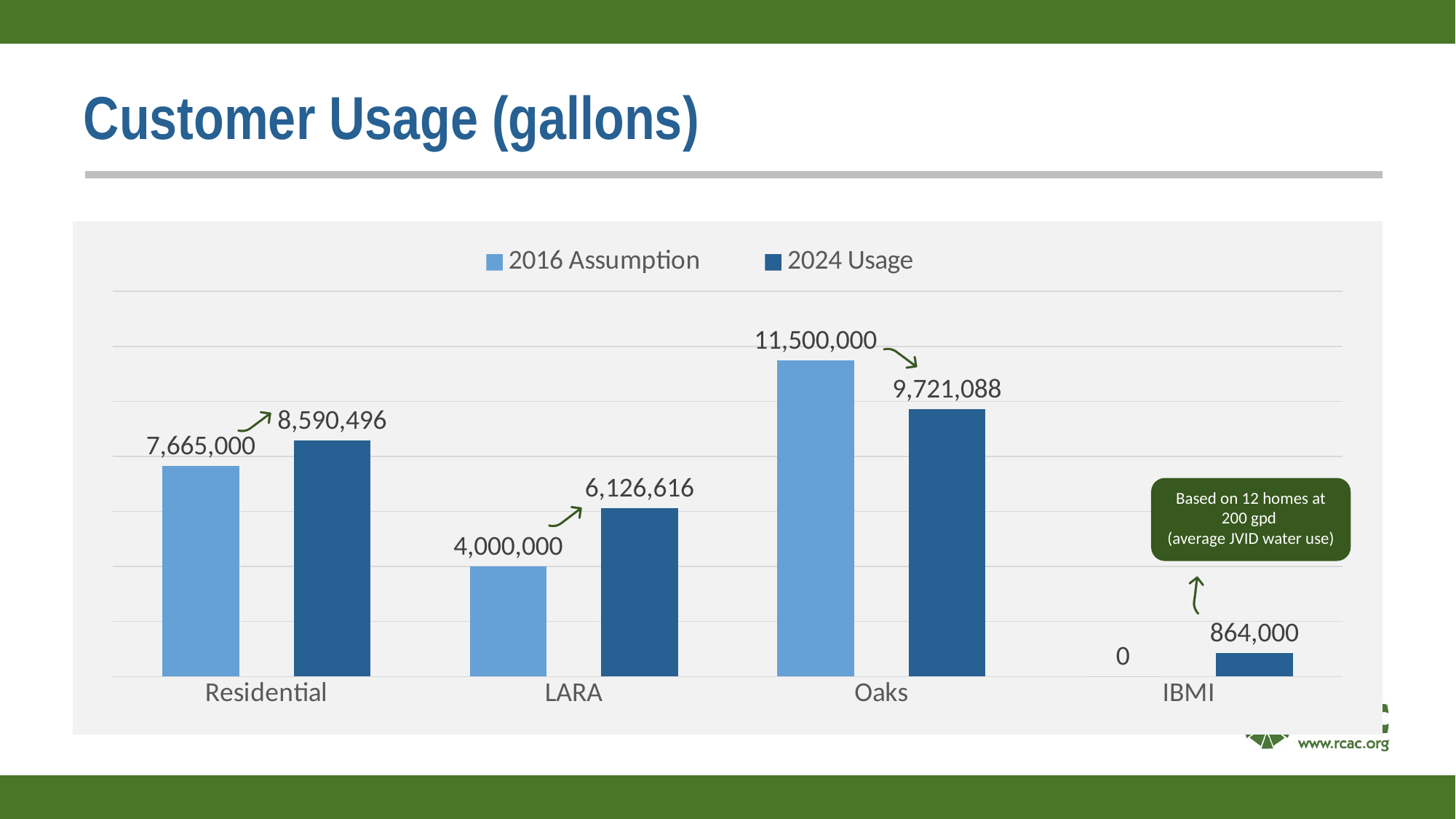
For LARA, which is larger: the 2016 Assumption or the 2024 Usage? 2024 Usage What is the difference between the 2016 Assumption and the 2024 Usage for Oaks? 1,778,912 Which category has the lowest 2024 Usage value? IBMI Which category has the highest 2016 Assumption value? Oaks What is the 2024 Usage value for Oaks? 9,721,088 What is the 2016 Assumption value for IBMI? 0 What is the difference between the 2024 Usage and the 2016 Assumption for Residential? 925,496 What is the 2024 Usage value for LARA? 6,126,616 What is the 2016 Assumption value for Residential? 7,665,000 What kind of chart is shown on the slide? Bar chart How many categories are shown on the x axis? 4 How many series does the legend list? 2